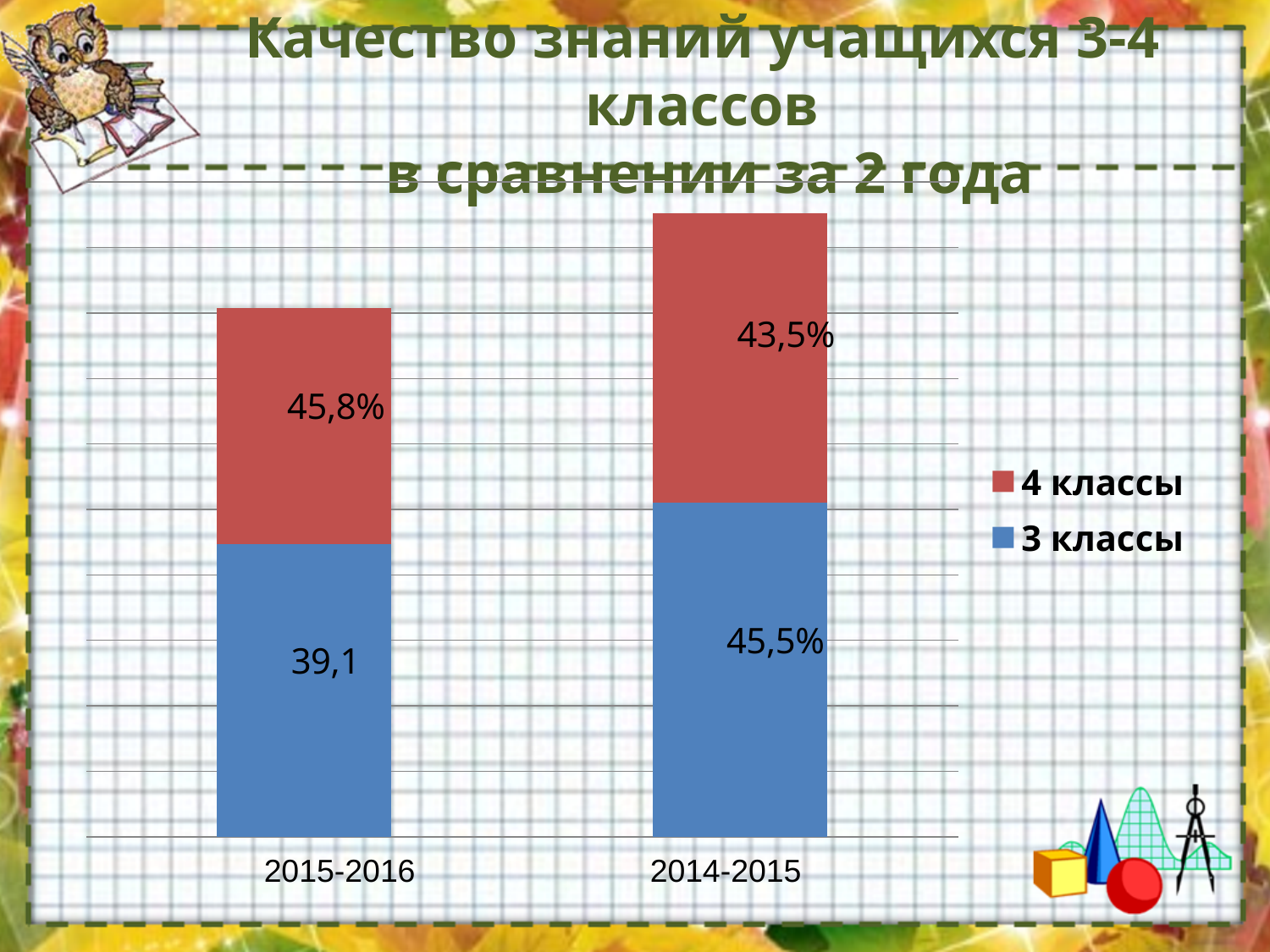
How many series does the legend list? 2 In which year is the value for 4 классы lower? 2014-2015 Which colour represents 3 классы in the chart? Blue What is the value for 3 классы in 2014-2015? 45,5% What kind of chart is shown on the slide? Stacked bar chart What is the value for 4 классы in 2015-2016? 45,8% What is the value for 3 классы in 2015-2016? 39,1 In which year is the value for 3 классы higher? 2014-2015 What is the value for 4 классы in 2014-2015? 43,5% What is the difference between the 4 классы values for 2015-2016 and 2014-2015? 2,3 How many year categories are shown on the x axis? 2 In 2014-2015, which is larger: the value for 3 классы or for 4 классы? 3 классы